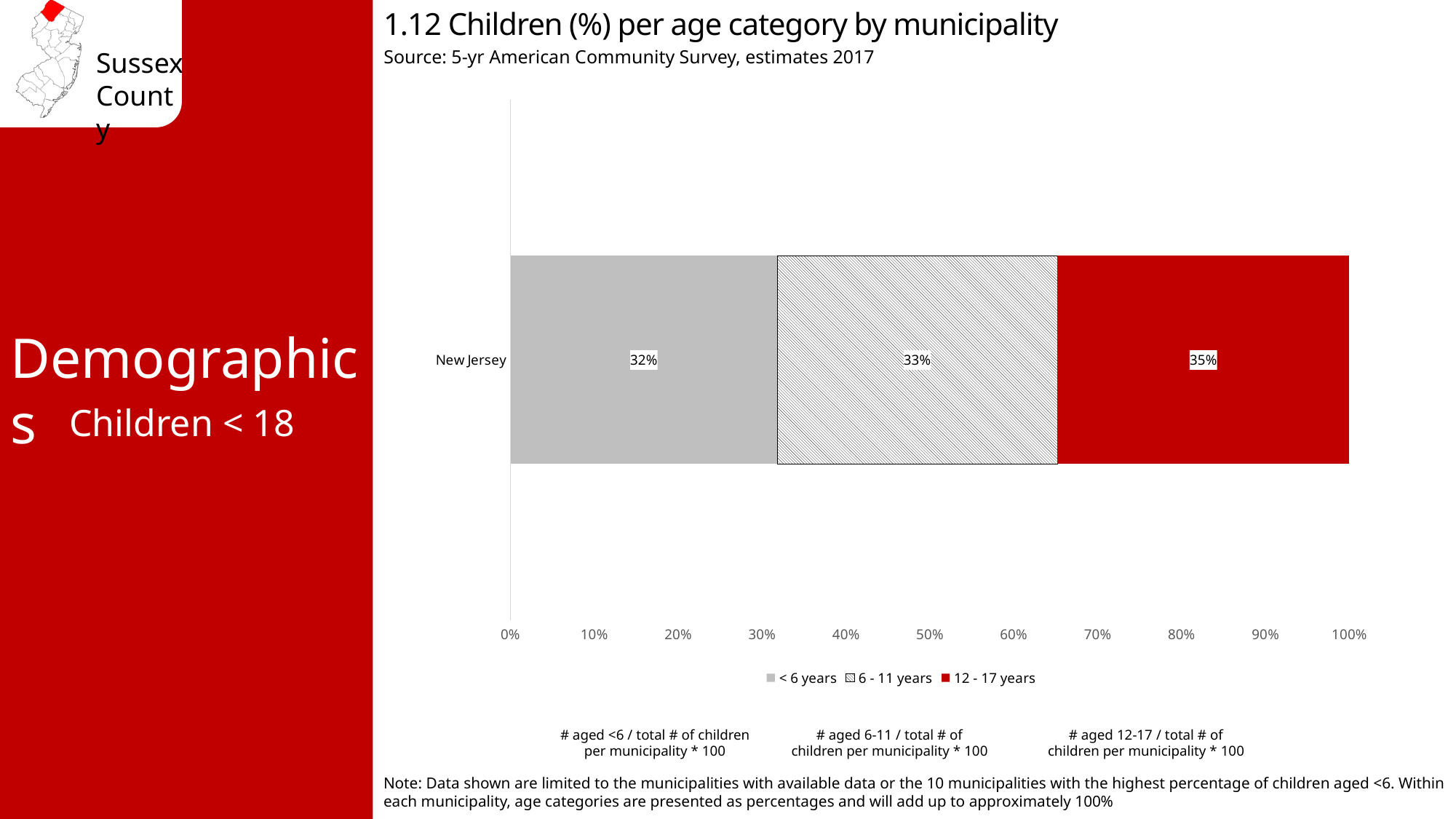
Which age category has the highest percentage for New Jersey? 12 - 17 years What percentage of children in New Jersey are aged under 6 years? 32% What is the difference between the 12 - 17 years and < 6 years percentages for New Jersey? 3% Which is larger for New Jersey: the 6 - 11 years share or the 12 - 17 years share? 12 - 17 years What kind of chart is shown? Stacked bar chart What percentage of children in New Jersey are aged 12 - 17 years? 35% What percentage of children in New Jersey are aged 6 - 11 years? 33% What is the title of the chart? 1.12 Children (%) per age category by municipality What is the total of the stacked bar for New Jersey? 100% Which age category has the lowest percentage for New Jersey? < 6 years How many series does the legend list? 3 How many municipalities are plotted on the chart? 1